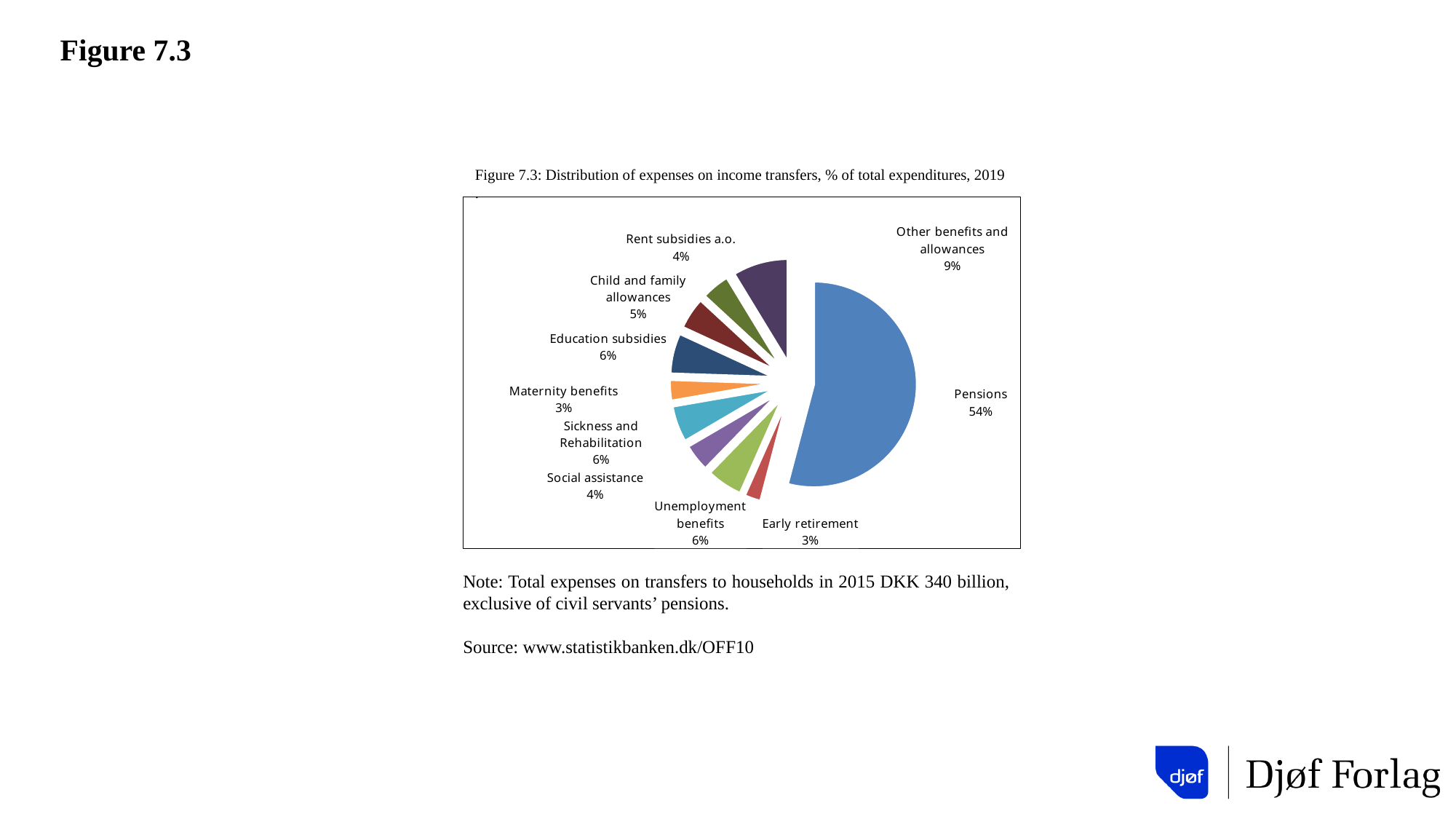
What is the value for Other benefits and allowances? 9% What is the value for Early retirement? 3% What is the difference between the shares for Education subsidies and Maternity benefits? 3% What is the difference between the shares for Pensions and Other benefits and allowances? 45% What is the value for Education subsidies? 6% Which is larger, the share for Unemployment benefits or the share for Social assistance? Unemployment benefits What is the value for Child and family allowances? 5% What is the title of the chart? Figure 7.3: Distribution of expenses on income transfers, % of total expenditures, 2019 How many categories (slices) does the pie chart show? 10 Which category has the largest slice of the pie? Pensions What kind of chart is shown on the slide? pie chart What share of total expenditures goes to Pensions? 54%